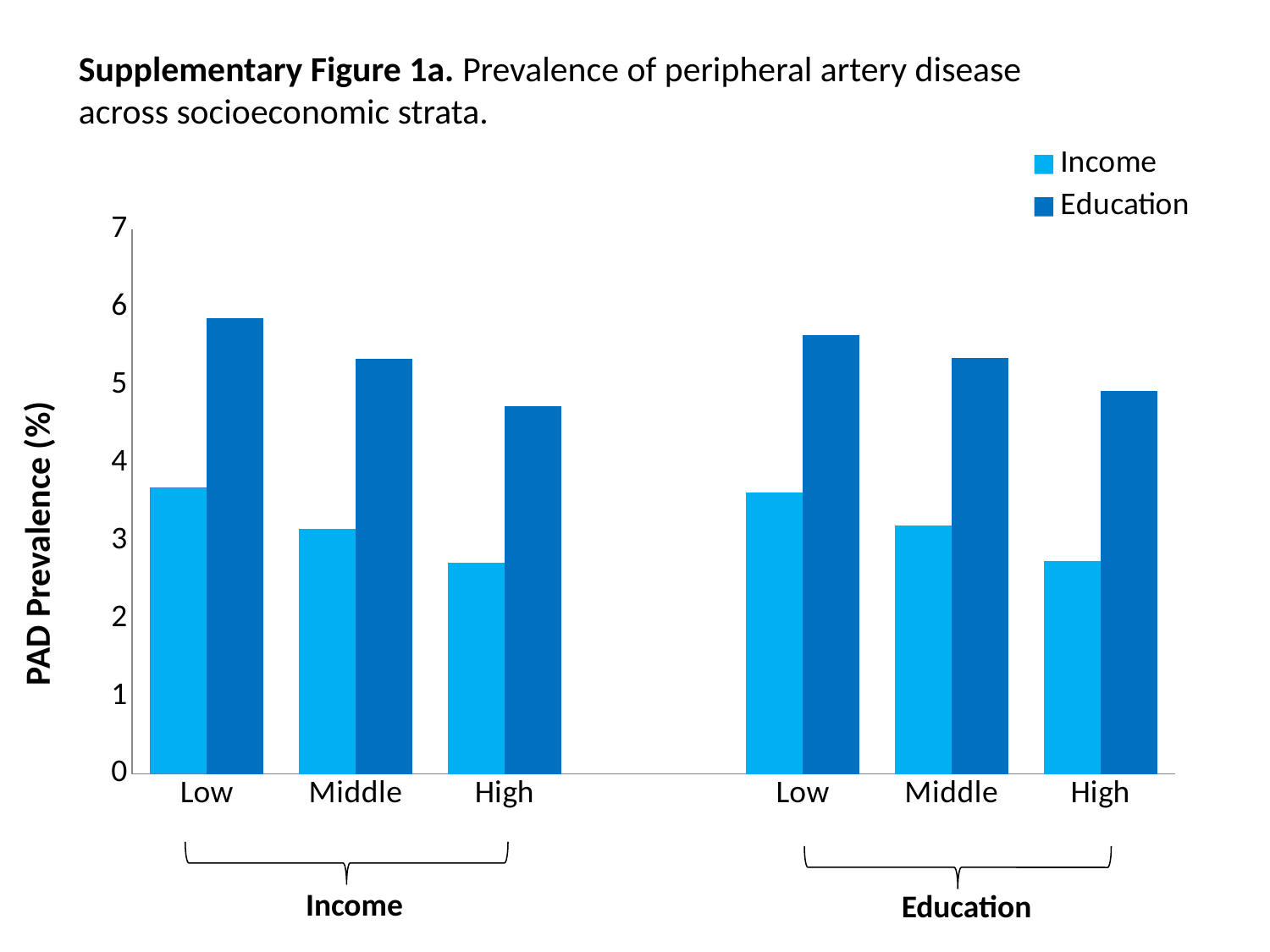
What is the label of the y axis? PAD Prevalence (%) What kind of chart is shown on the slide? bar chart Within the Income group, which category has the highest Education series value? Low Is the Income series value for Low in the Education group greater or less than 4? less Do the Income series values rise or fall from Low to High within the Income group? fall Which is larger for Middle in the Income group: the Income series or the Education series? Education Is the Education series value for Low in the Income group greater or less than 5? greater How many categories are shown along the x axis? 6 How many series does the legend list? 2 Within the Education group, which category has the lowest Income series value? High Is the Education series value for High in the Education group greater or less than 4? greater